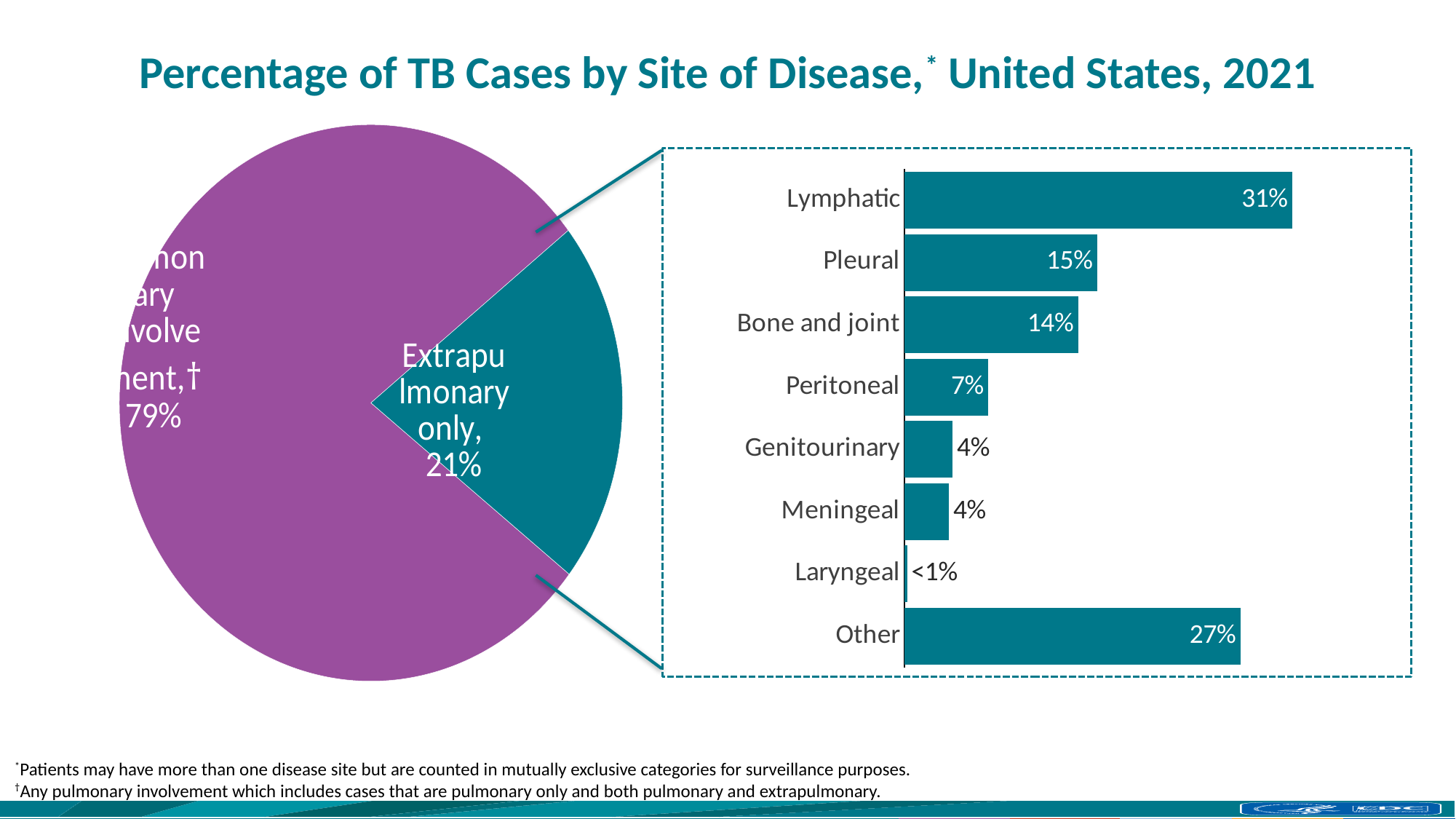
In the bar chart on the right, which site has the lowest percentage? Laryngeal In the bar chart on the right, what is the difference in percentage points between Lymphatic and Other? 4 percentage points How many disease sites are listed in the bar chart on the right? 8 In the bar chart on the right, what percentage is shown for Lymphatic? 31% In the bar chart on the right, what percentage is shown for Pleural? 15% What kind of chart is shown on the right side of the slide? Bar chart In the bar chart on the right, what percentage is shown for Other? 27% In the bar chart on the right, what is the difference in percentage points between Pleural and Peritoneal? 8 percentage points In the bar chart on the right, which has a higher percentage, Pleural or Bone and joint? Pleural In the bar chart on the right, which site has the highest percentage? Lymphatic In the pie chart on the left, what percentage is shown for Extrapulmonary only? 21% In the bar chart on the right, what percentage is shown for Peritoneal? 7%